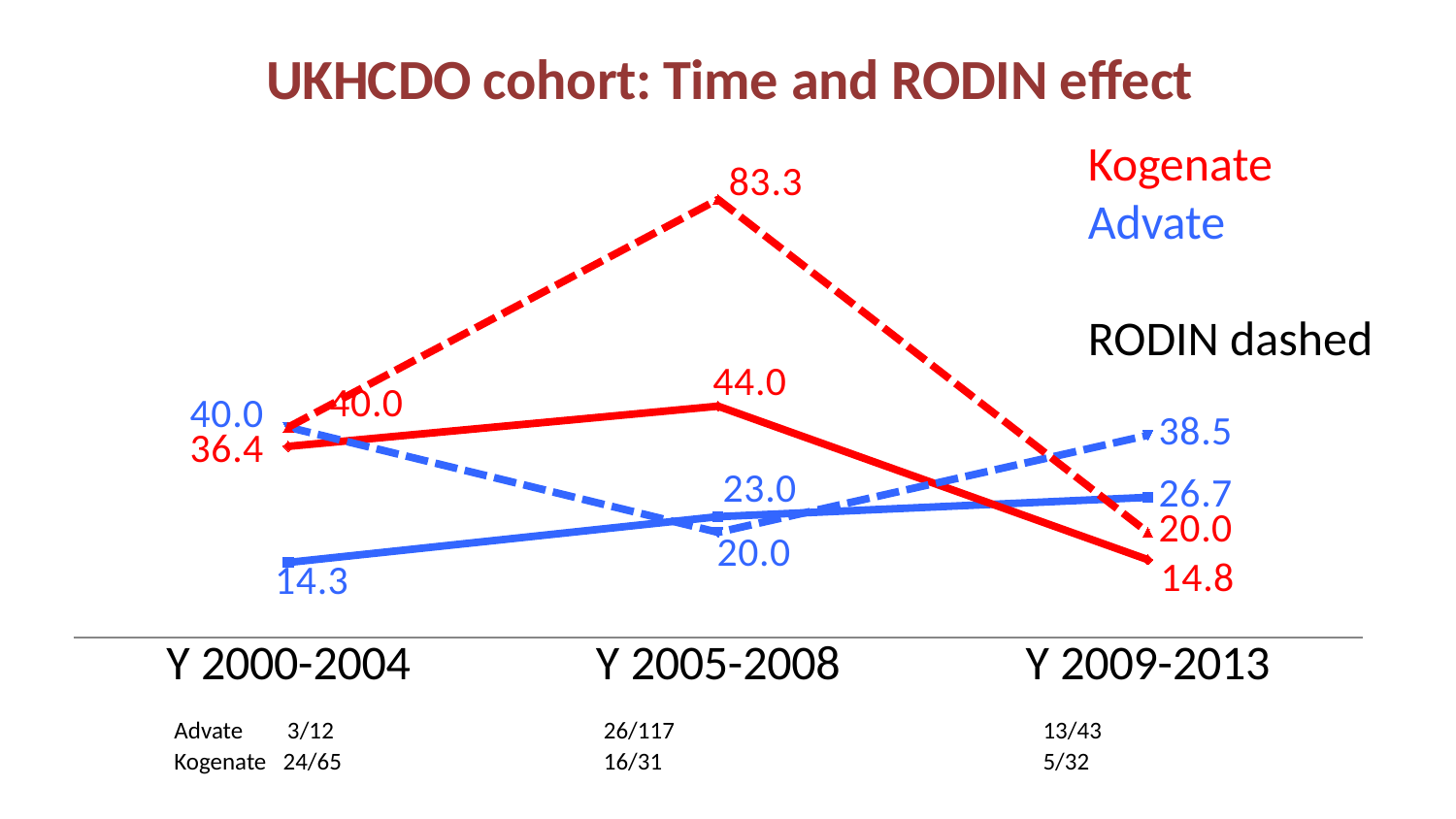
What is the value of the solid Kogenate line for Y 2009-2013? 14.8 What is the value of the dashed Advate (RODIN) line for Y 2009-2013? 38.5 For Y 2009-2013, which is larger: the solid Advate value or the solid Kogenate value? solid Advate (26.7) What is the value of the dashed Kogenate (RODIN) line for Y 2005-2008? 83.3 Which time period has the lowest value on the solid Advate line? Y 2000-2004 Which colour represents Kogenate in the chart? red How many time periods are shown on the x axis? 3 Which time period has the highest value on the dashed Kogenate (RODIN) line? Y 2005-2008 What is the value of the solid Advate line for Y 2000-2004? 14.3 What is the difference between the solid Kogenate values for Y 2005-2008 and Y 2009-2013? 29.2 Does the solid Advate line rise or fall from Y 2000-2004 to Y 2009-2013? rise What type of chart is shown on the slide? line chart